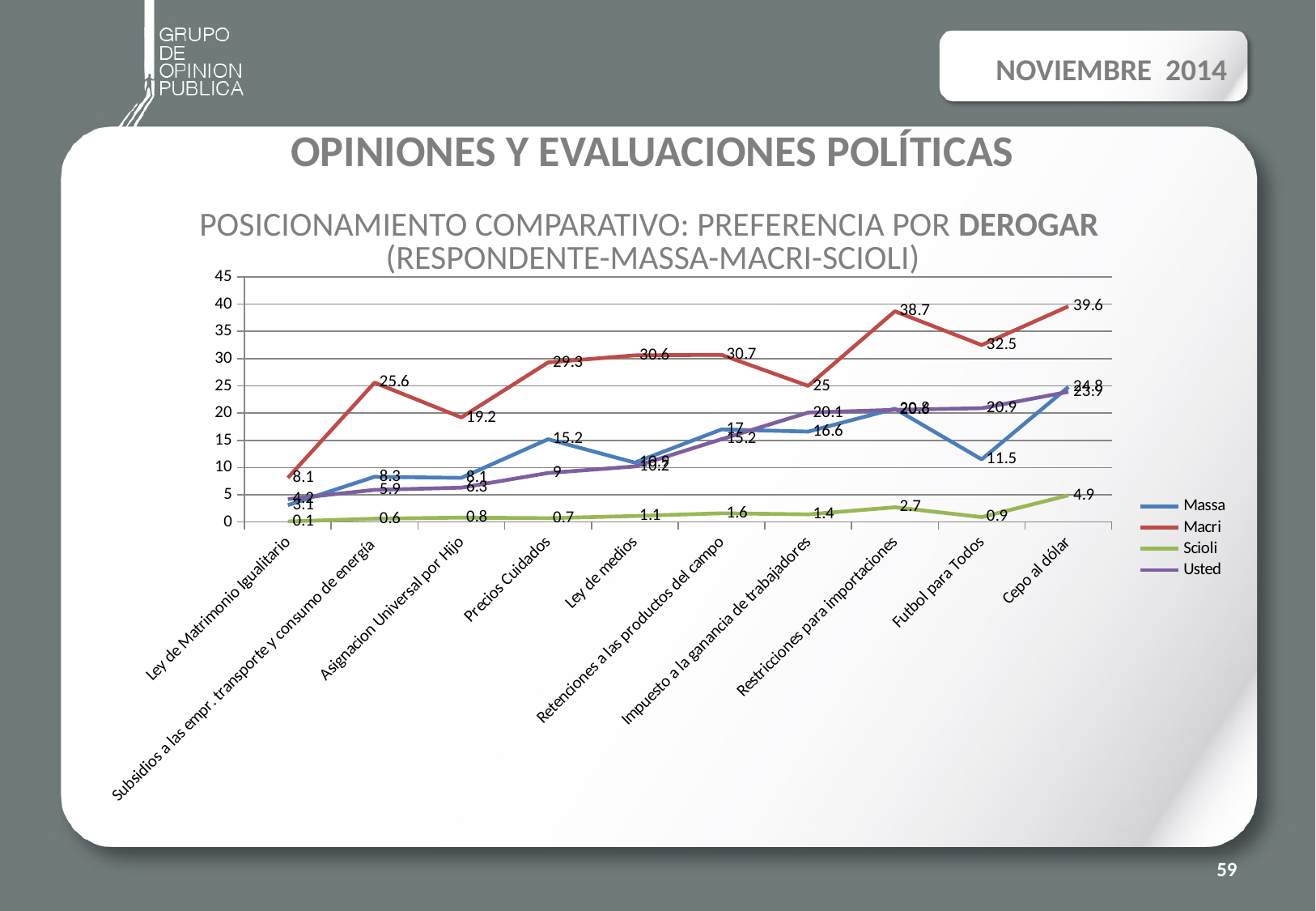
How many series does the legend list? 4 For which category is the Macri value highest? Cepo al dólar What is the value for Massa at Futbol para Todos? 11.5 What is the value for Macri at Cepo al dólar? 39.6 What is the value for Scioli at Cepo al dólar? 4.9 At Precios Cuidados, which is larger: the value for Massa or the value for Usted? Massa How many categories are shown along the x axis? 10 Is the value for Massa at Retenciones a las productos del campo greater or less than 15? greater What is the value for Usted at Impuesto a la ganancia de trabajadores? 20.1 What type of chart is shown on the slide? line chart What is the difference between the Macri values for Restricciones para importaciones and Futbol para Todos? 6.2 For which category is the Scioli value lowest? Ley de Matrimonio Igualitario